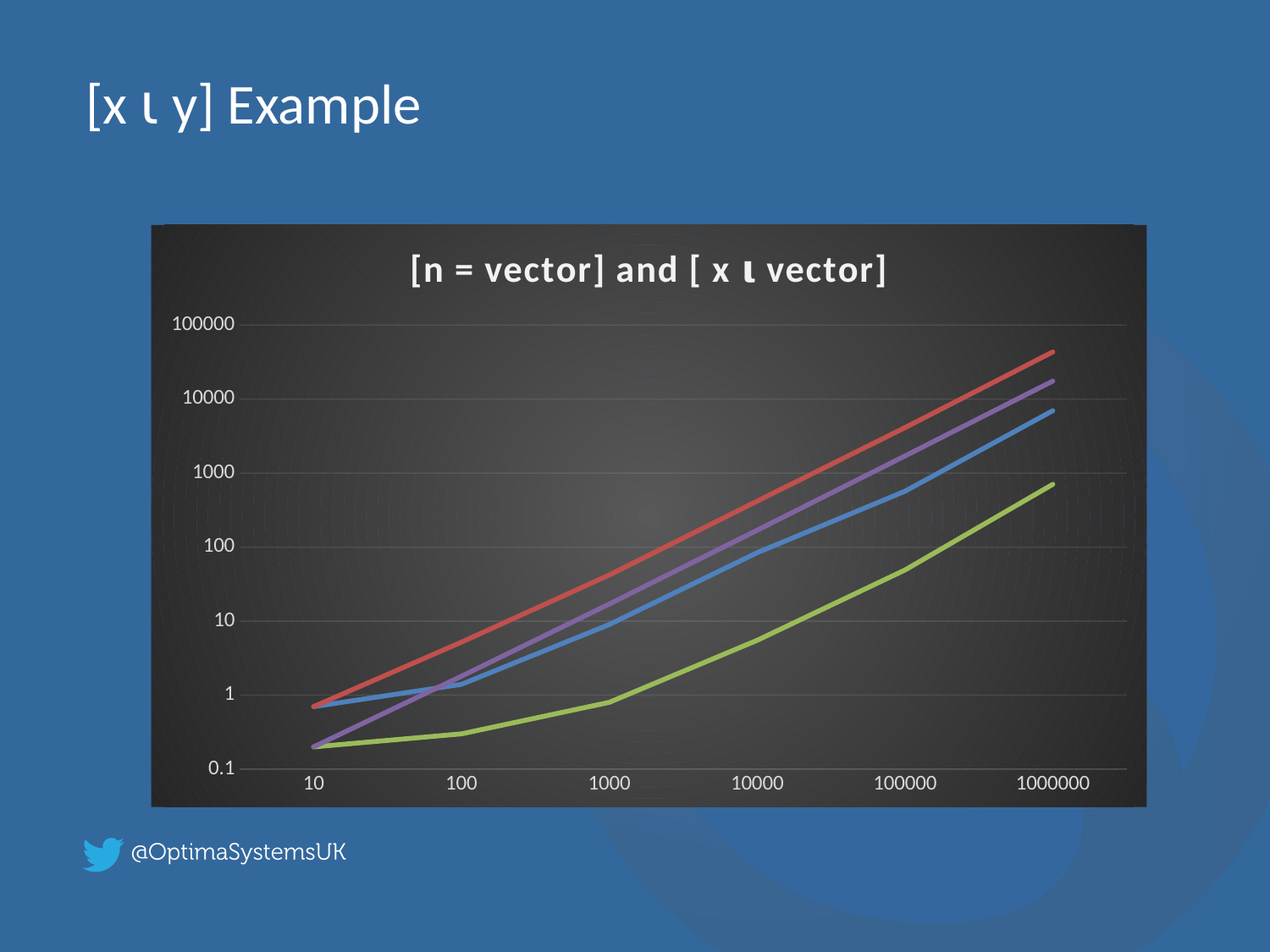
At x = 1000000, which line has the larger value, the purple line or the blue line? purple How many lines are plotted on the chart? 4 What kind of chart is shown on the slide? line chart Is the value of the red line at x = 1000000 greater or less than 10000? greater Is the value of the green line at x = 1000000 greater or less than 1000? less What is the title of the chart? [n = vector] and [ x ⍳ vector] Is the value of the green line at x = 100000 greater or less than 100? less Do the values of the red line rise or fall as the x axis increases from 10 to 1000000? rise At x = 10, which line has the larger value, the blue line or the purple line? blue Which coloured line has the highest value at x = 1000000? red Which coloured line has the lowest value at x = 1000000? green How many points are marked along the x axis of the chart? 6